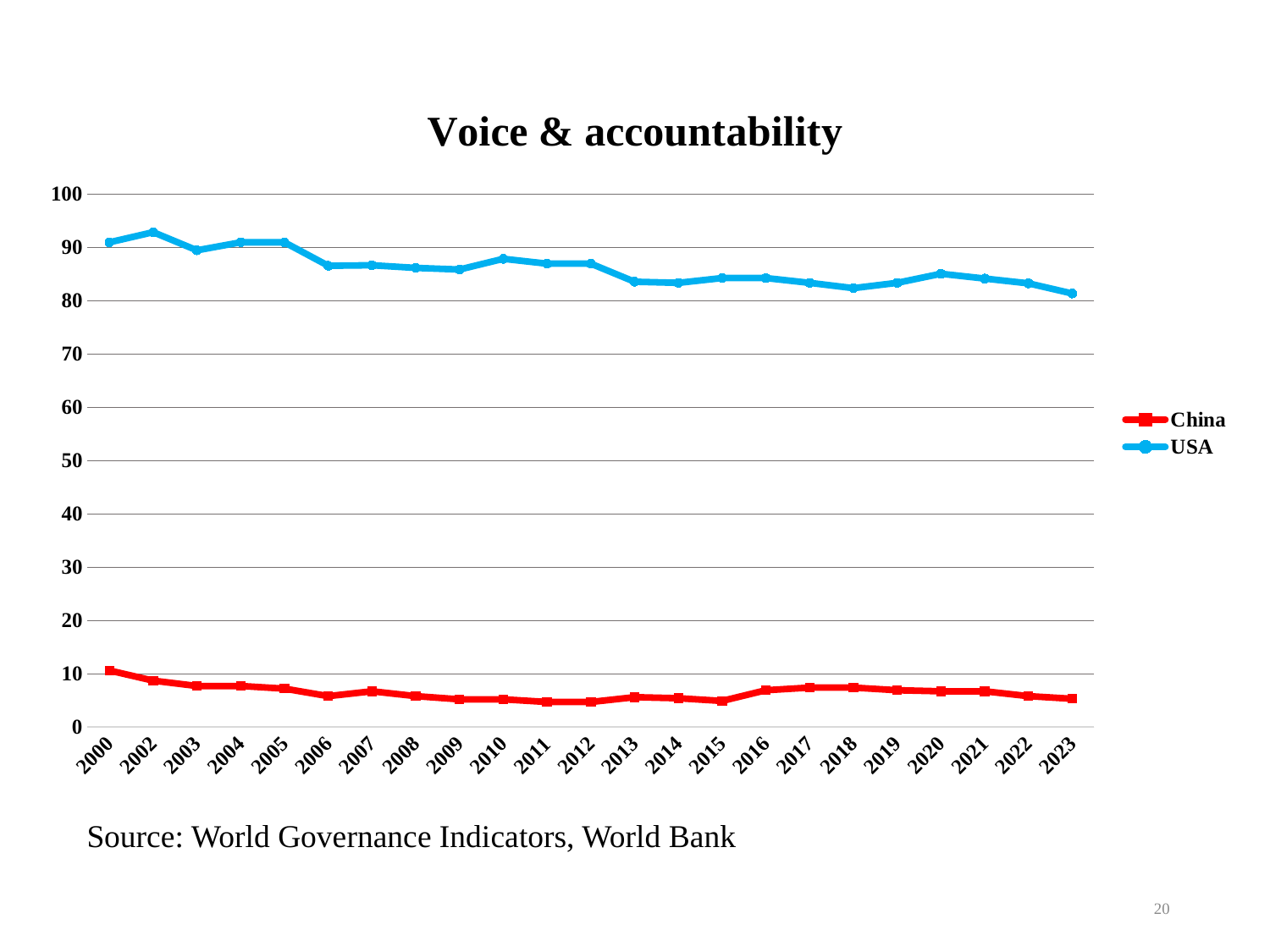
How many years are plotted along the x axis? 23 In 2023, which series has the higher value, China or USA? USA Is the value for USA in 2013 greater or less than 90? less Is the value for USA in 2002 greater or less than 90? greater Which colour is used for the USA line? Blue What kind of chart is shown on the slide? Line chart How many series does the legend list? 2 In which year does the China series reach its highest value? 2000 In which year does the USA series reach its highest value? 2002 Does the USA series generally rise or fall from 2000 to 2023? Fall What is the title of the chart? Voice & accountability Is the value for China in 2023 greater or less than 10? less